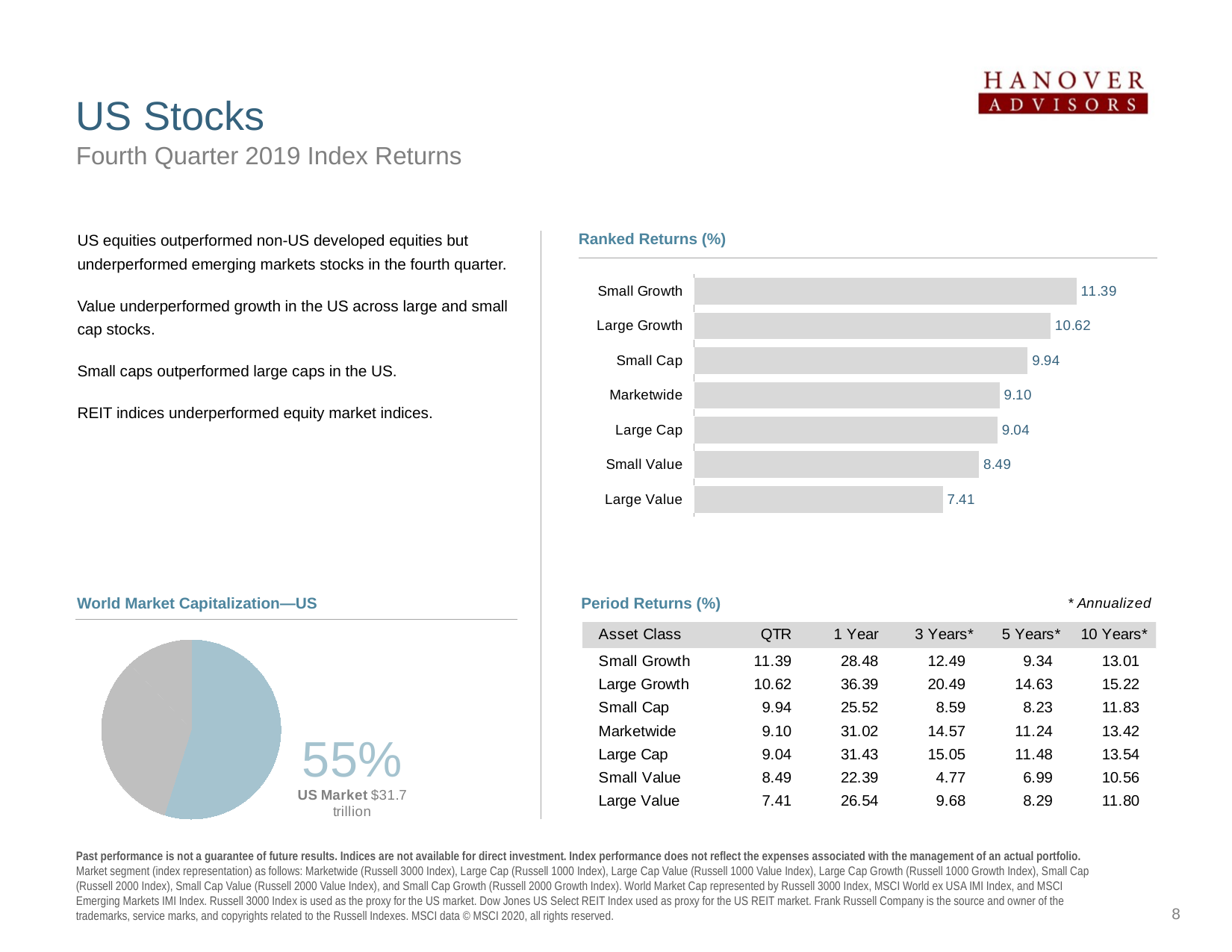
What kind of chart is the World Market Capitalization—US chart? Pie chart In the Ranked Returns (%) chart, what is the value for Large Value? 7.41 In the Ranked Returns (%) chart, which category has the lowest value? Large Value In the Ranked Returns (%) chart, what is the difference between Small Value and Large Value? 1.08 In the Ranked Returns (%) chart, which is larger, Small Cap or Large Cap? Small Cap In the Ranked Returns (%) chart, which category has the highest value? Small Growth In the Ranked Returns (%) chart, what is the value for Small Growth? 11.39 How many categories are shown in the Ranked Returns (%) chart? 7 What kind of chart is the Ranked Returns (%) chart? Bar chart In the Ranked Returns (%) chart, what is the value for Marketwide? 9.10 In the Ranked Returns (%) chart, what is the difference between Small Growth and Large Growth? 0.77 In the World Market Capitalization—US chart, what share of the pie does the US Market represent? 55%